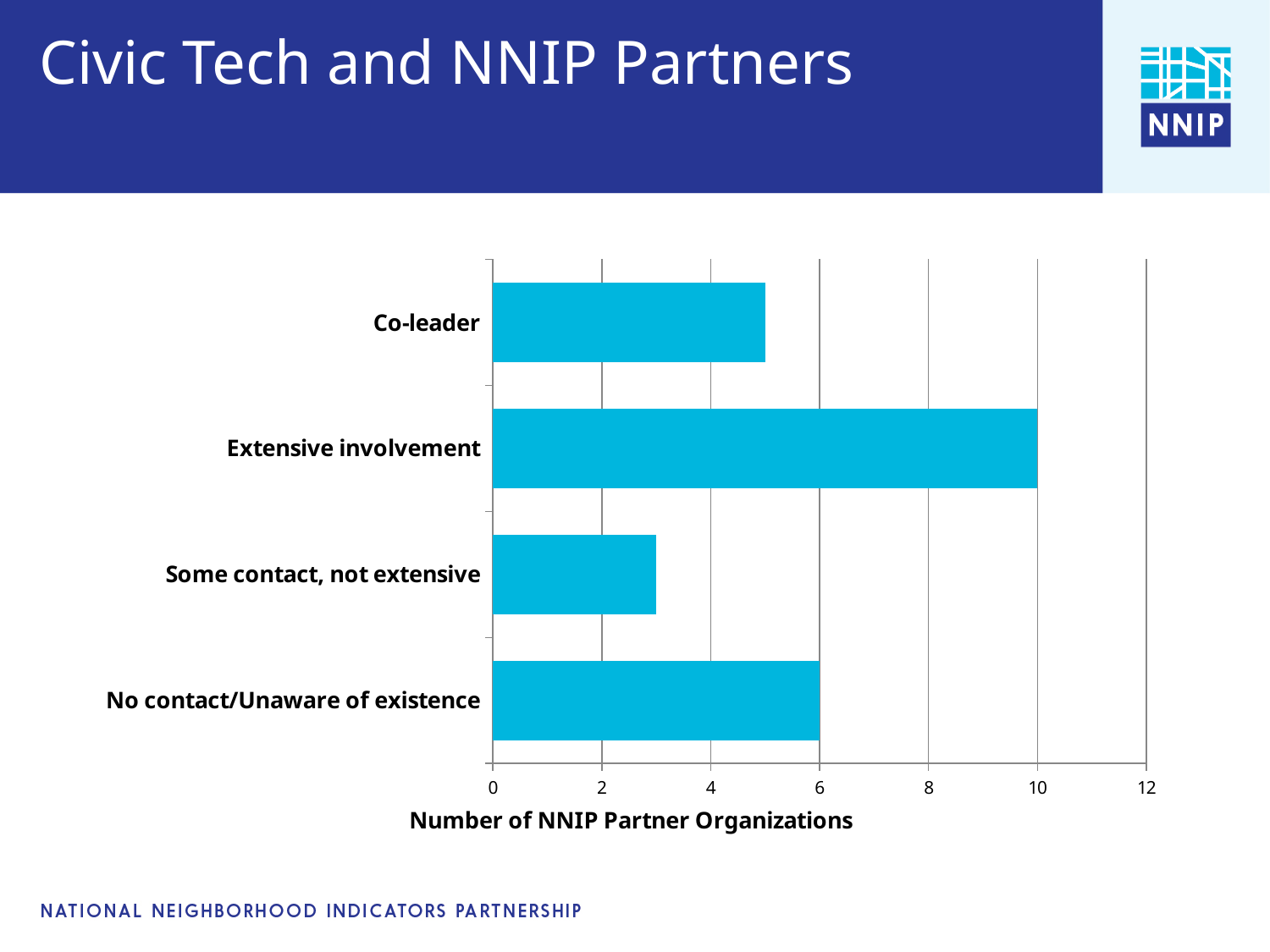
Is the value for Some contact, not extensive greater or less than 4? less How many categories are shown in the chart? 4 What is the label of the horizontal axis? Number of NNIP Partner Organizations Is the value for Co-leader greater or less than 4? greater What is the value for Extensive involvement? 10 What is the difference between the values for Extensive involvement and No contact/Unaware of existence? 4 Which is larger, the value for Co-leader or the value for No contact/Unaware of existence? No contact/Unaware of existence What is the value for No contact/Unaware of existence? 6 Which category has the lowest number of NNIP partner organizations? Some contact, not extensive Is the value for Co-leader greater or less than 6? less Which category has the highest number of NNIP partner organizations? Extensive involvement What kind of chart is shown on the slide? bar chart